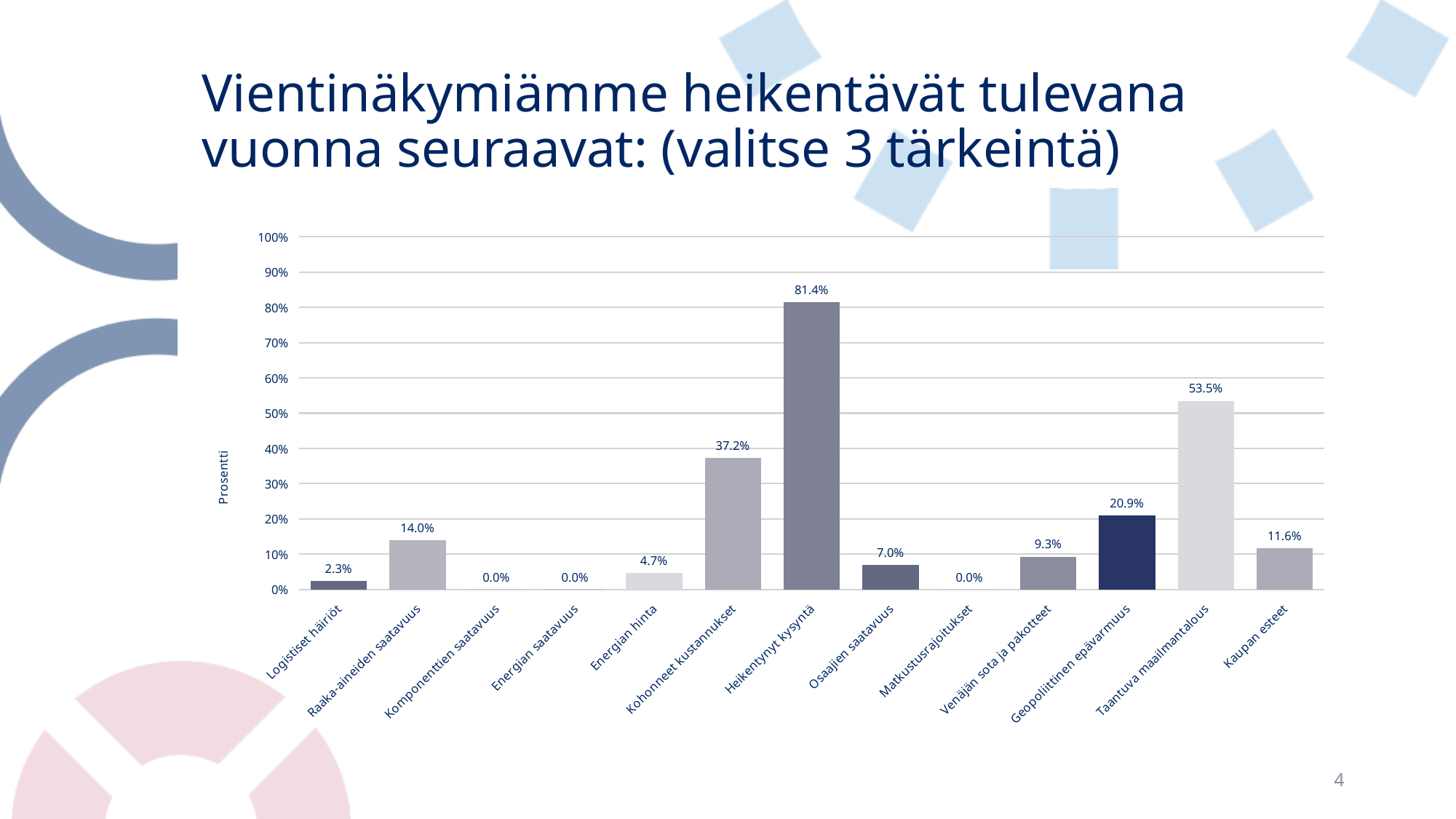
Is the value for Kohonneet kustannukset greater or less than 30%? greater How many categories are shown on the x axis? 13 What kind of chart is shown on the slide? Bar chart What is the value for Venäjän sota ja pakotteet? 9.3% What is the difference between the values for Kohonneet kustannukset and Geopoliittinen epävarmuus? 16.3% How many categories have a value of 0.0%? 3 What is the value for Taantuva maailmantalous? 53.5% What is the difference between the values for Heikentynyt kysyntä and Taantuva maailmantalous? 27.9% Which category has the highest value? Heikentynyt kysyntä Which is larger, the value for Raaka-aineiden saatavuus or the value for Kaupan esteet? Raaka-aineiden saatavuus What is the value for Heikentynyt kysyntä? 81.4% What is the value for Geopoliittinen epävarmuus? 20.9%